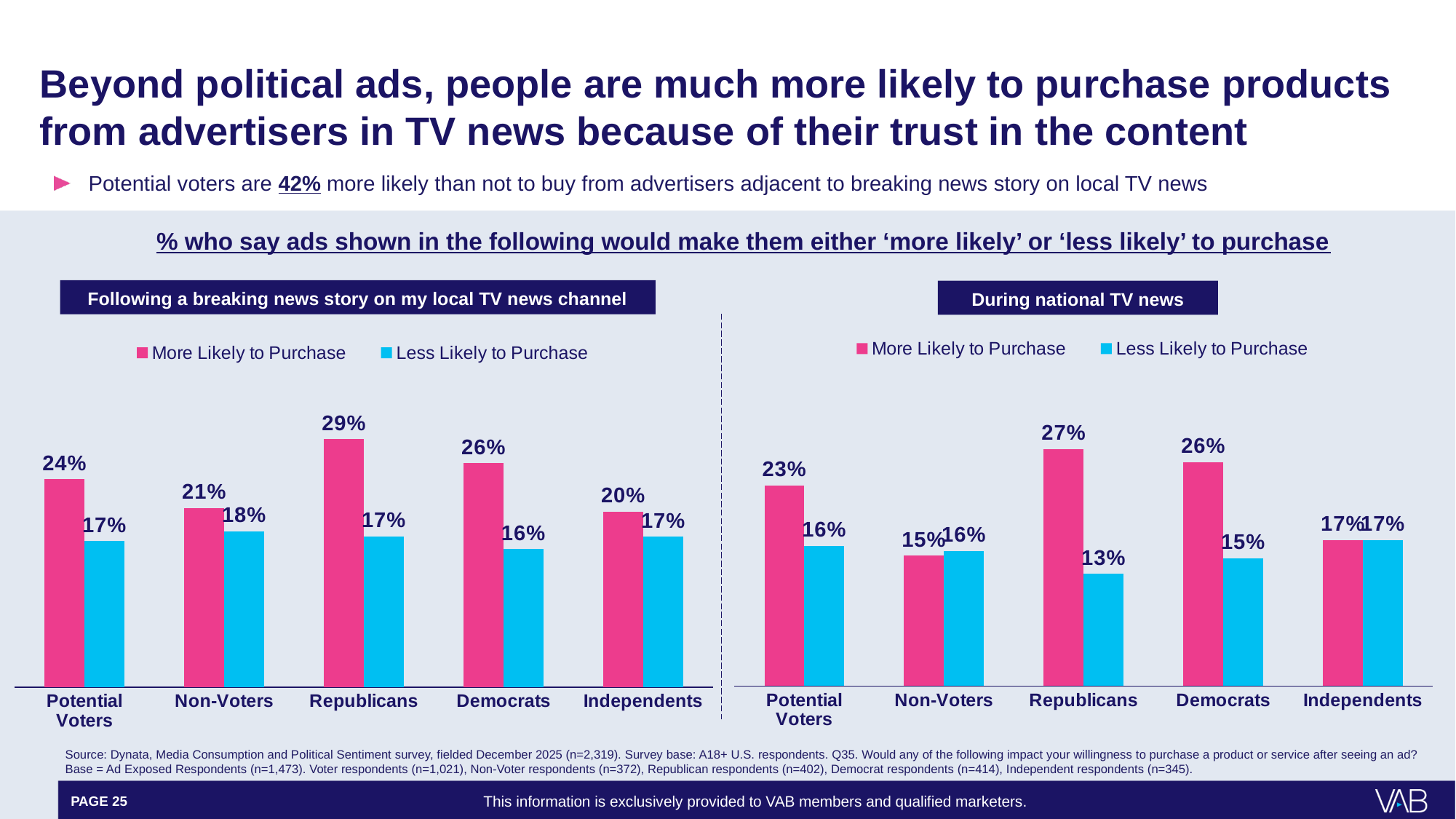
How many series does the legend of the 'During national TV news' chart list? 2 In the 'During national TV news' chart, what is the 'More Likely to Purchase' value for Independents? 17% In the 'During national TV news' chart, what is the difference between the 'More Likely to Purchase' values for Republicans and Potential Voters? 4% In the 'Following a breaking news story on my local TV news channel' chart, which category has the highest 'More Likely to Purchase' value? Republicans How many categories are shown on the x axis of the 'Following a breaking news story on my local TV news channel' chart? 5 In the 'During national TV news' chart, what is the 'Less Likely to Purchase' value for Republicans? 13% In the 'Following a breaking news story on my local TV news channel' chart, what is the 'More Likely to Purchase' value for Republicans? 29% In the 'Following a breaking news story on my local TV news channel' chart, what is the difference between the 'More Likely to Purchase' and 'Less Likely to Purchase' values for Democrats? 10% In the 'During national TV news' chart, which category has the lowest 'More Likely to Purchase' value? Non-Voters What kind of chart is the 'During national TV news' chart? Bar chart In the 'During national TV news' chart, which is larger for Non-Voters: 'More Likely to Purchase' or 'Less Likely to Purchase'? Less Likely to Purchase In the 'Following a breaking news story on my local TV news channel' chart, which colour represents 'Less Likely to Purchase'? Blue